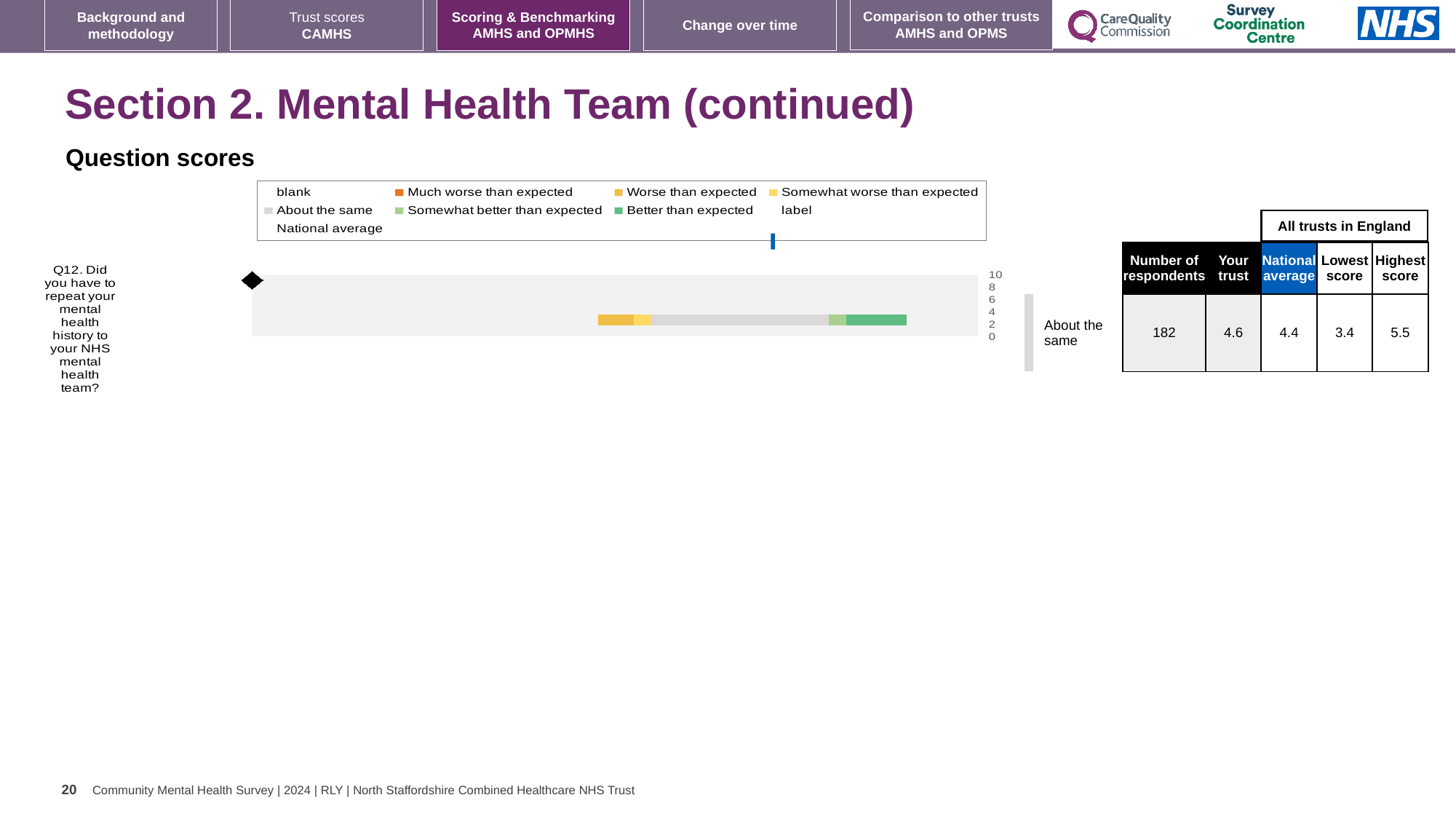
What is the highest score among all trusts in England for Q12? 5.5 What kind of chart is used to show the Q12 question score? bar chart How many respondents answered Q12? 182 What is the lowest score among all trusts in England for Q12? 3.4 By how much does the 'Your trust' score for Q12 exceed the national average? 0.2 For Q12, which is larger: the 'Your trust' score or the national average? Your trust What benchmark category is shown to the right of the Q12 bar? About the same What is the national average score for Q12? 4.4 Which legend entry is shown in dark green? Better than expected How many survey questions are plotted in the chart? 1 What is the 'Your trust' score for Q12? 4.6 What is the difference between the highest and lowest scores for Q12 across all trusts in England? 2.1